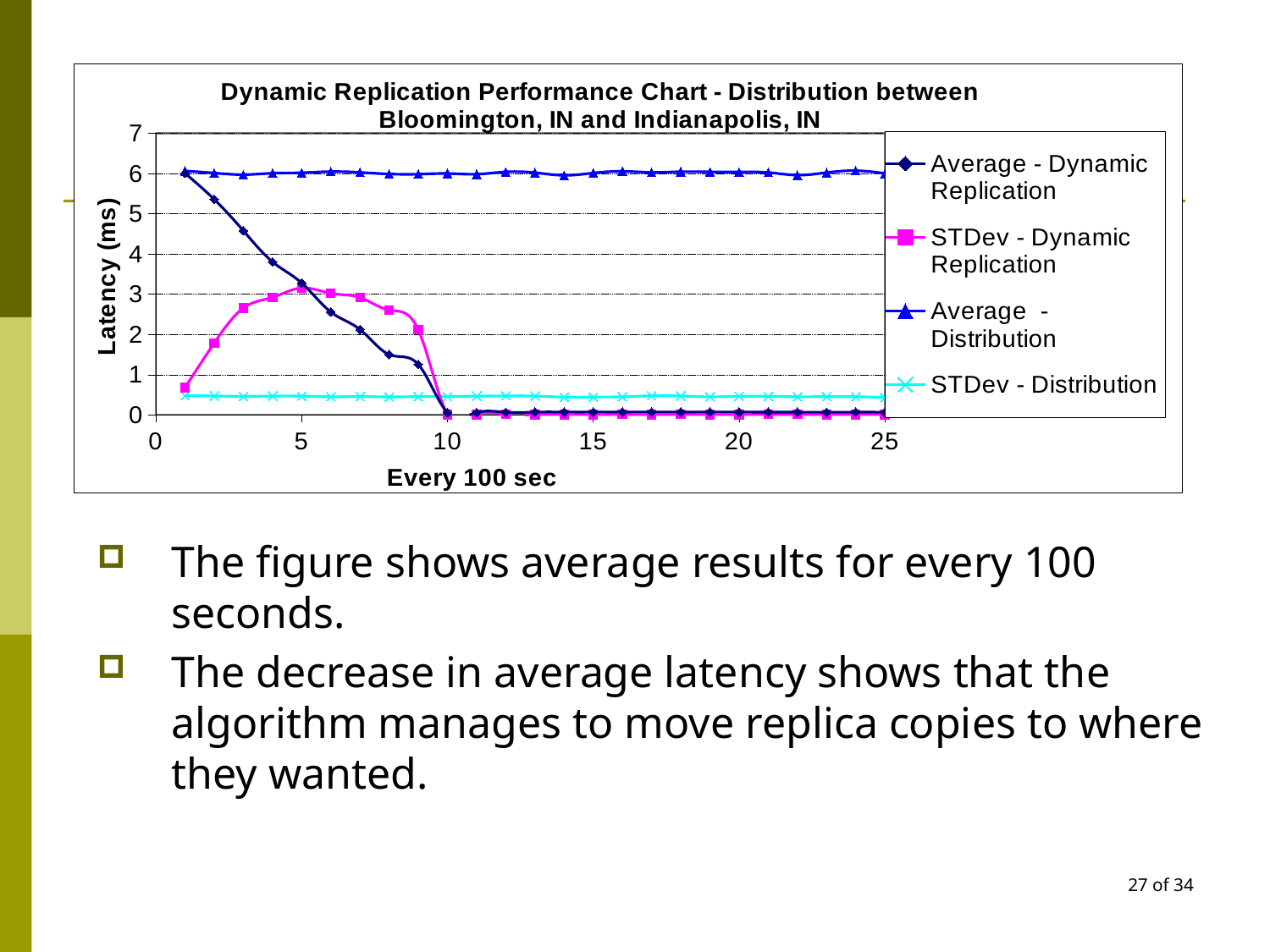
Is the value for STDev - Dynamic Replication at x = 5 greater or less than 2? greater Is the value for Average - Dynamic Replication at x = 1 greater or less than 5? greater Which series has the highest value at x = 25? Average - Distribution Is the value for Average - Dynamic Replication at x = 20 greater or less than 1? less At x = 20, which is larger: Average - Distribution or Average - Dynamic Replication? Average - Distribution How many series does the chart's legend list? 4 What kind of chart is shown on the slide? line chart What is the title of the chart's x axis? Every 100 sec At x = 3, which is larger: Average - Dynamic Replication or STDev - Dynamic Replication? Average - Dynamic Replication Do the values for Average - Dynamic Replication rise or fall as the x axis increases? fall